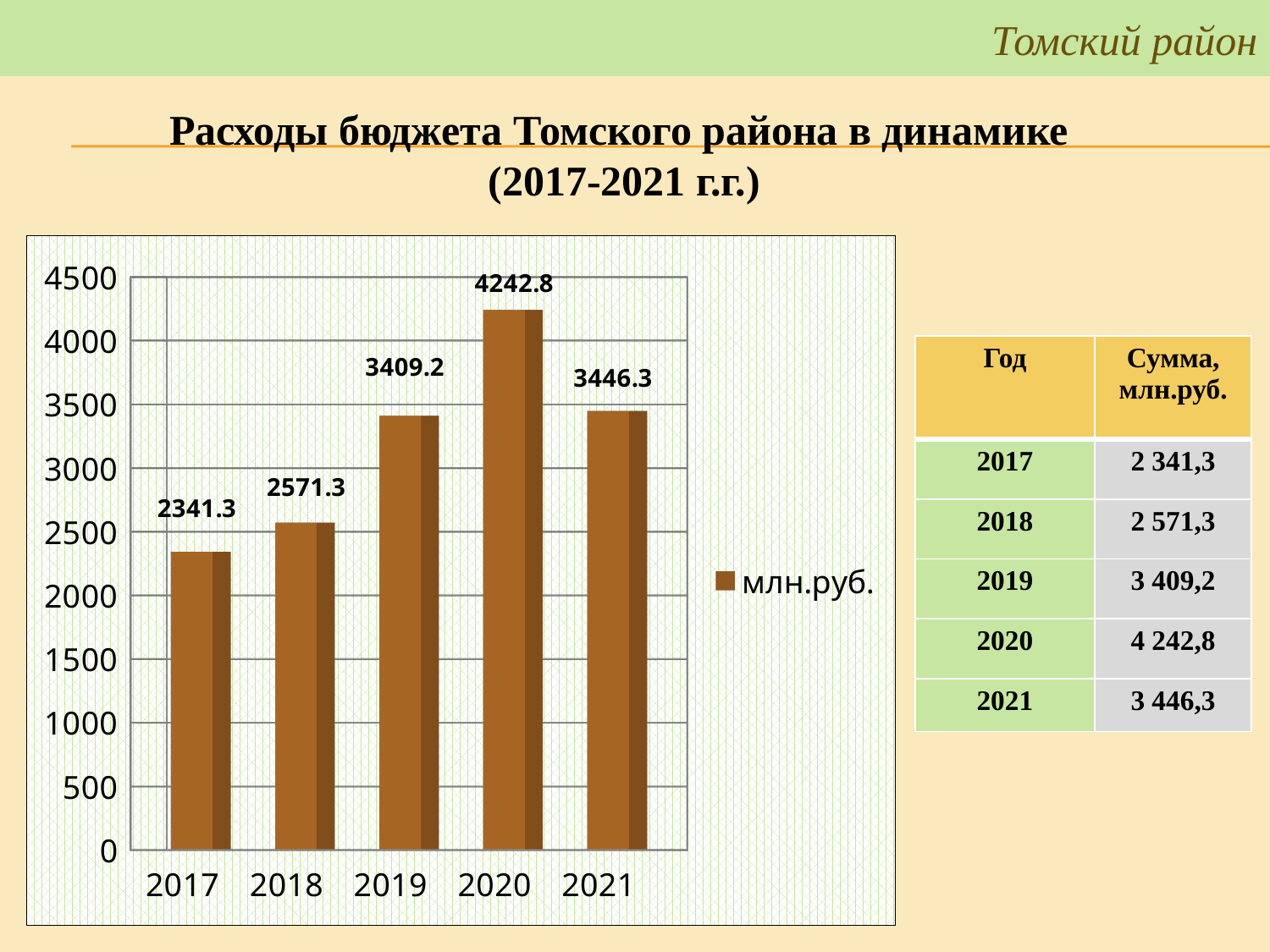
Is the value for 2018 greater or less than 3000? less What kind of chart is shown on the slide? bar chart What is the value for 2019 in the chart? 3409.2 What is the difference between the values for 2020 and 2019? 833.6 What is the value for 2017 in the chart? 2341.3 Which year has the highest value in the chart? 2020 What is the difference between the values for 2018 and 2017? 230.0 What is the legend entry of the chart? млн.руб. Which year has the lowest value in the chart? 2017 What is the value for 2020 in the chart? 4242.8 Which is larger, the value for 2021 or the value for 2019? 2021 How many years are shown on the x axis of the chart? 5